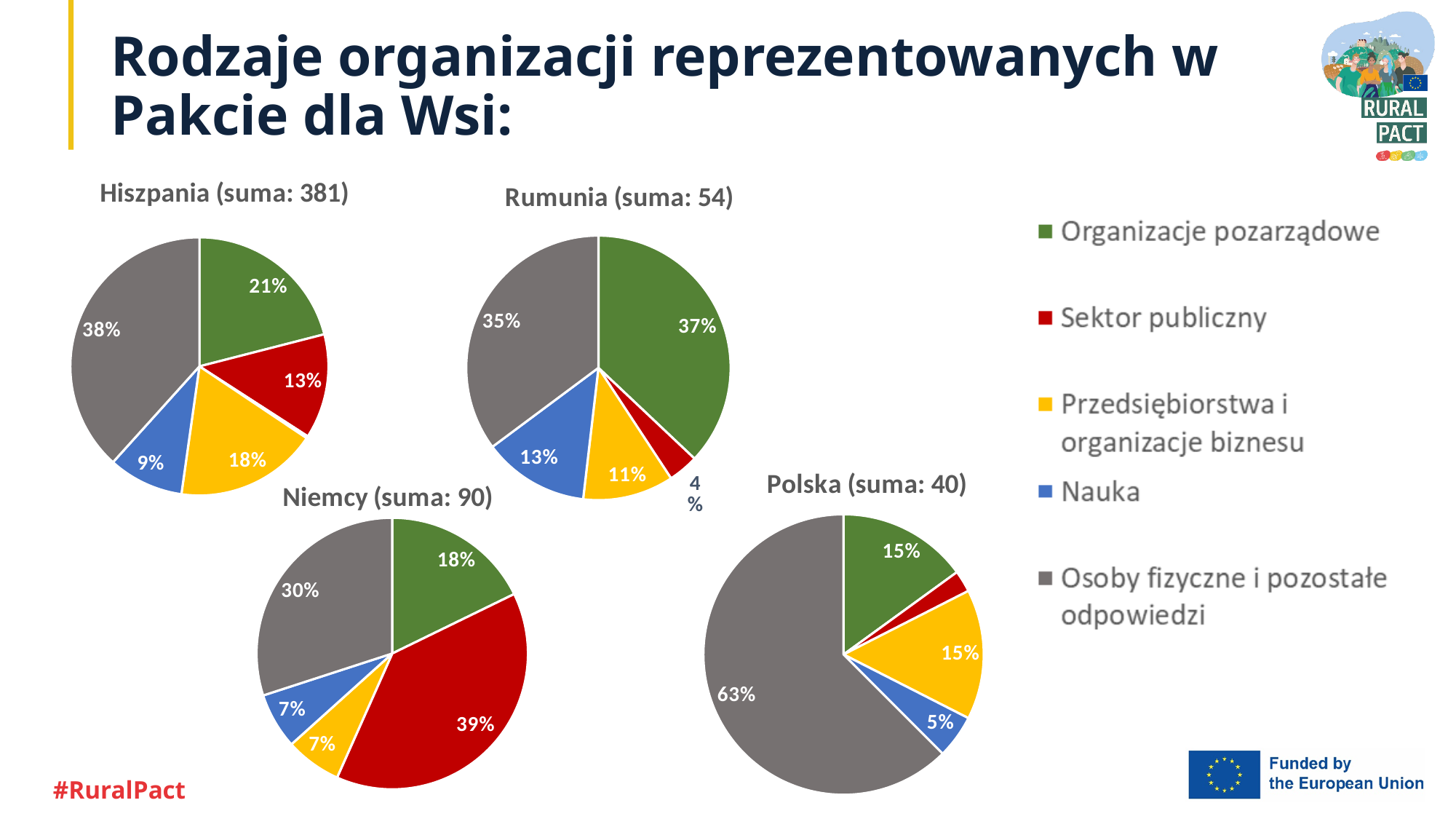
In the Hiszpania (suma: 381) pie chart, what share is shown for Osoby fizyczne i pozostałe odpowiedzi? 38% Which colour represents Nauka in the legend? Blue How many pie charts are shown on the slide? 4 What kind of chart is used for Niemcy (suma: 90)? Pie chart In the Hiszpania (suma: 381) pie chart, what is the difference between the shares for Organizacje pozarządowe and Nauka? 12 percentage points In the Polska (suma: 40) pie chart, what share is shown for Nauka? 5% In the Niemcy (suma: 90) pie chart, what share is shown for Sektor publiczny? 39% How many categories does the legend list? 5 In the Polska (suma: 40) pie chart, which is larger: the share for Osoby fizyczne i pozostałe odpowiedzi or the share for Organizacje pozarządowe? Osoby fizyczne i pozostałe odpowiedzi In the Niemcy (suma: 90) pie chart, which category has the largest share? Sektor publiczny In the Rumunia (suma: 54) pie chart, which category has the smallest share? Sektor publiczny In the Rumunia (suma: 54) pie chart, what share is shown for Organizacje pozarządowe? 37%